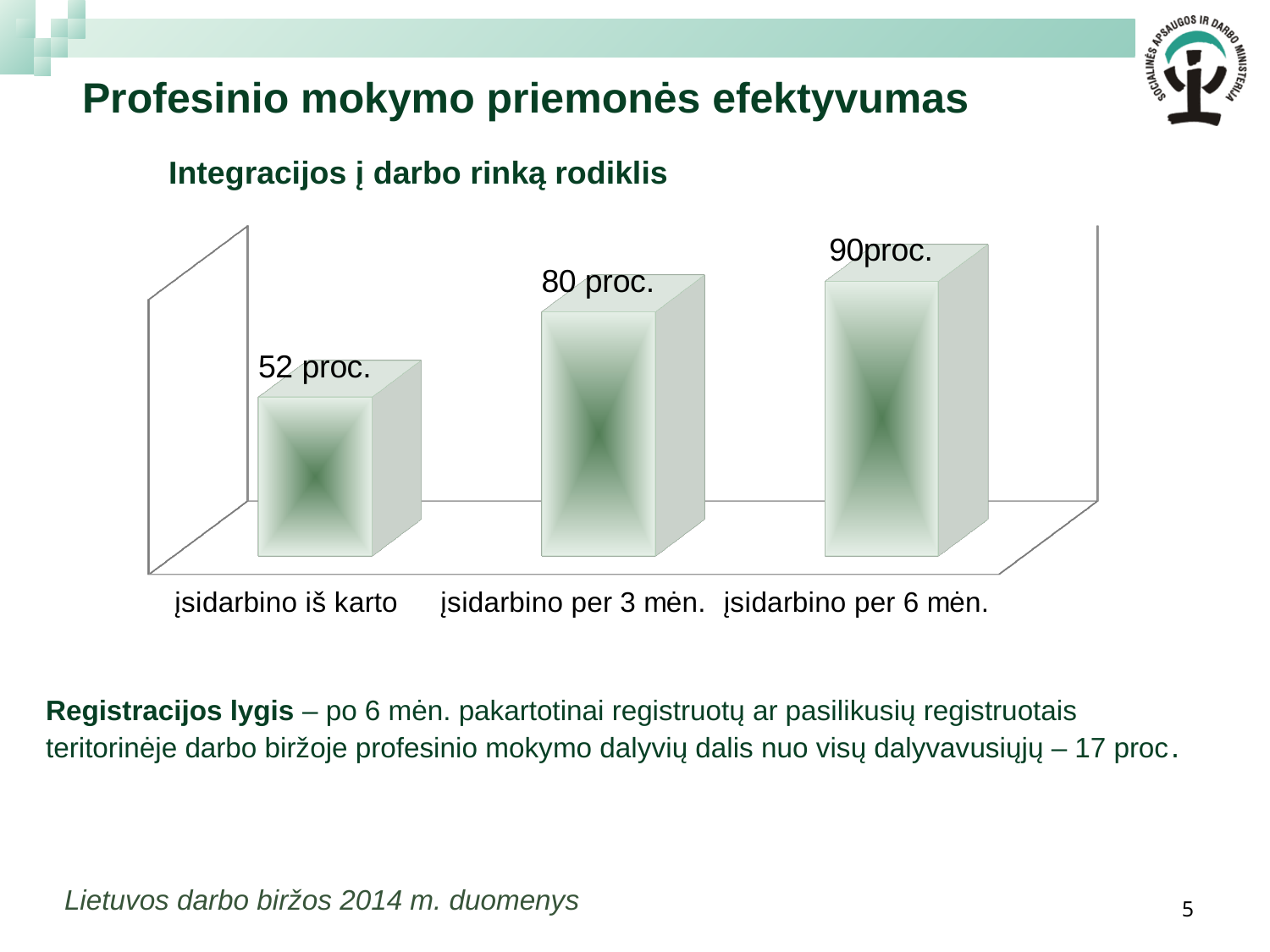
What is the difference between the values for "įsidarbino per 3 mėn." and "įsidarbino iš karto"? 28 proc. Do the values rise or fall from left to right across the categories? rise What is the value for "įsidarbino per 6 mėn."? 90proc. What is the difference between the values for "įsidarbino per 6 mėn." and "įsidarbino per 3 mėn."? 10 proc. Which category has the highest value? įsidarbino per 6 mėn. What is the title of the chart? Integracijos į darbo rinką rodiklis How many categories are shown in the chart? 3 What is the value for "įsidarbino iš karto"? 52 proc. Which is larger, the value for "įsidarbino iš karto" or for "įsidarbino per 3 mėn."? įsidarbino per 3 mėn. Which category has the lowest value? įsidarbino iš karto What is the value for "įsidarbino per 3 mėn."? 80 proc. What kind of chart is shown on the slide? bar chart